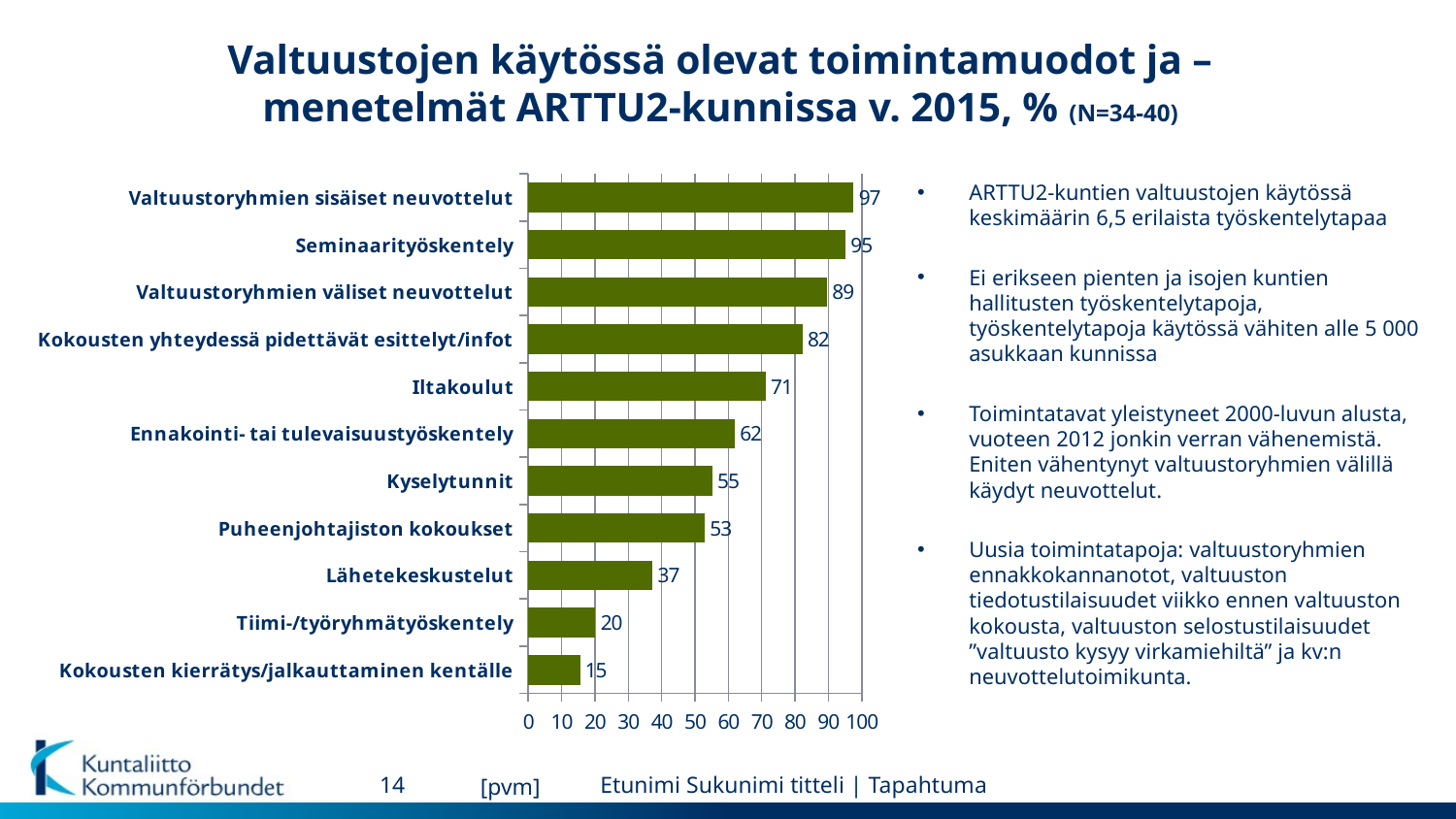
What is the value for Seminaarityöskentely? 95 What kind of chart is shown on the slide? bar chart Which is larger, the value for Ennakointi- tai tulevaisuustyöskentely or the value for Puheenjohtajiston kokoukset? Ennakointi- tai tulevaisuustyöskentely What is the value for Lähetekeskustelut? 37 What is the highest tick value shown on the value axis? 100 Which category has the lowest value? Kokousten kierrätys/jalkauttaminen kentälle How many categories are shown in the chart? 11 What is the difference between the values for Valtuustoryhmien väliset neuvottelut and Kyselytunnit? 34 Is the value for Tiimi-/työryhmätyöskentely greater or less than 30? less What is the value for Iltakoulut? 71 Which category has the highest value? Valtuustoryhmien sisäiset neuvottelut What is the value for Kokousten yhteydessä pidettävät esittelyt/infot? 82